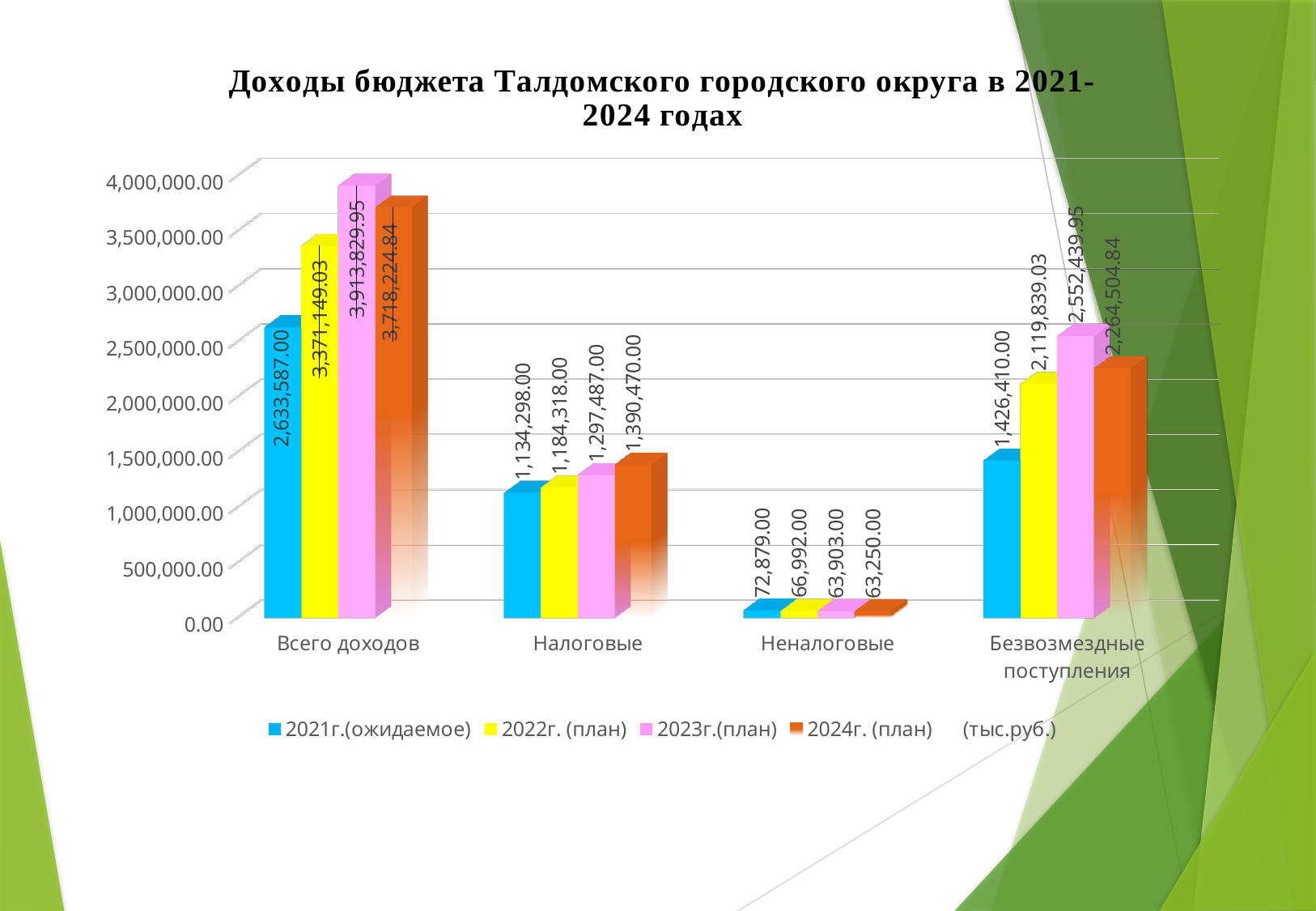
What is the value for Безвозмездные поступления in the 2023г.(план) series? 2,552,439.95 What is the value for Всего доходов in the 2021г.(ожидаемое) series? 2,633,587.00 What is the difference between the 2024г. (план) and 2021г.(ожидаемое) values for Налоговые? 256,172.00 Which category has the lowest values across all series? Неналоговые What is the value for Неналоговые in the 2024г. (план) series? 63,250.00 Which series has the highest value for Всего доходов? 2023г.(план) Which is larger for Безвозмездные поступления: the 2022г. (план) value or the 2024г. (план) value? 2024г. (план) Do the values for Неналоговые rise or fall from 2021 to 2024? fall What kind of chart is shown on the slide? bar chart What is the value for Налоговые in the 2022г. (план) series? 1,184,318.00 How many categories are shown on the x axis? 4 What is the title of the chart? Доходы бюджета Талдомского городского округа в 2021-2024 годах